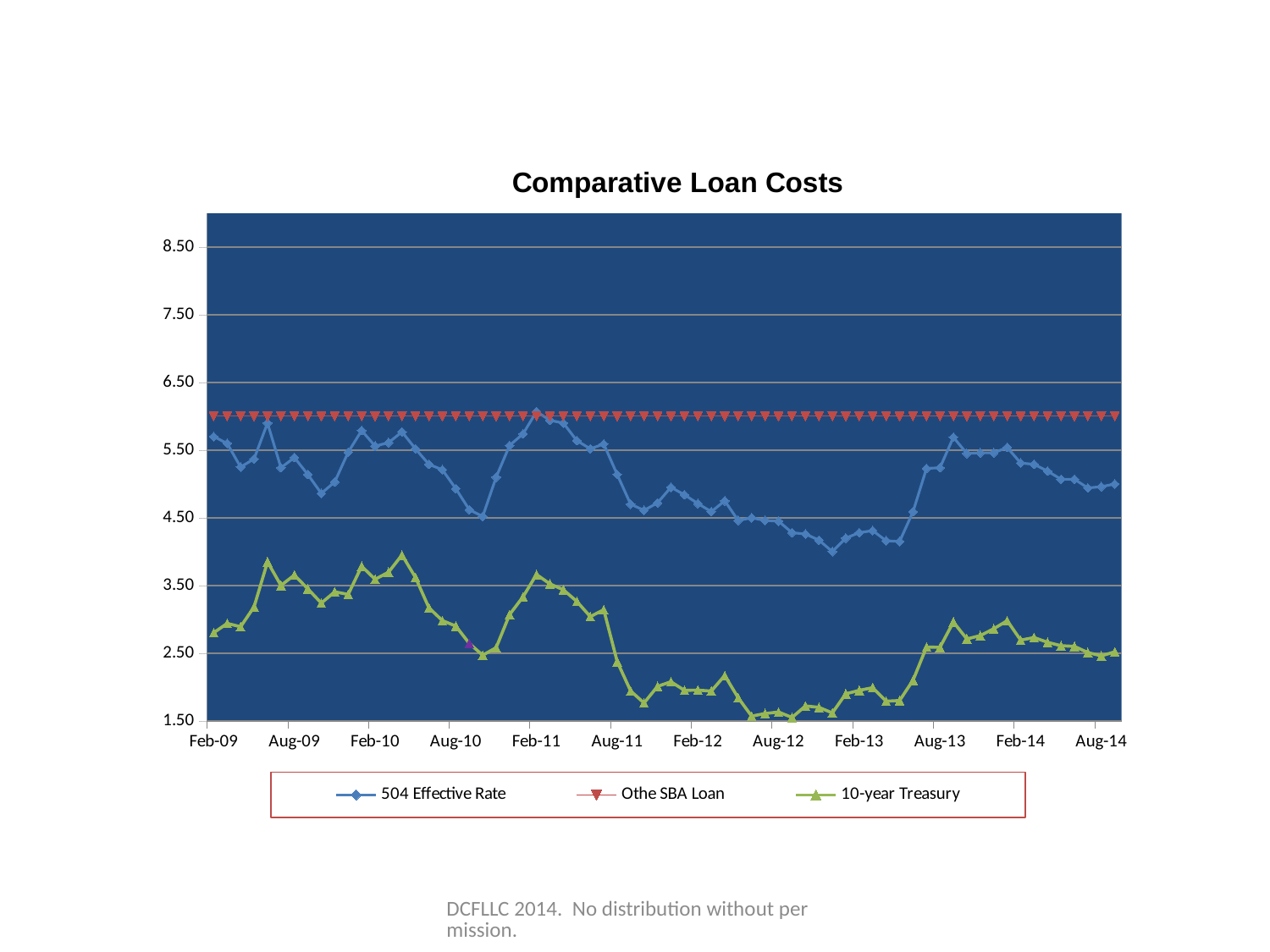
What is the title of the chart? Comparative Loan Costs How many date labels are shown on the x axis? 12 Which series is plotted with green triangle markers? 10-year Treasury At Aug-12, which is higher: the 504 Effective Rate or the Othe SBA Loan? Othe SBA Loan Which series has the lowest values across the whole chart? 10-year Treasury Is the 10-year Treasury value at Aug-12 greater or less than 2.50? less What kind of chart is shown on the slide? line chart Is the 504 Effective Rate value at Feb-13 greater or less than 4.50? less Is the value of the Othe SBA Loan series greater or less than 5.50? greater How many series does the legend list? 3 Does the 10-year Treasury series rise or fall between Feb-11 and Aug-12? fall Which series has the highest values across the whole chart? Othe SBA Loan